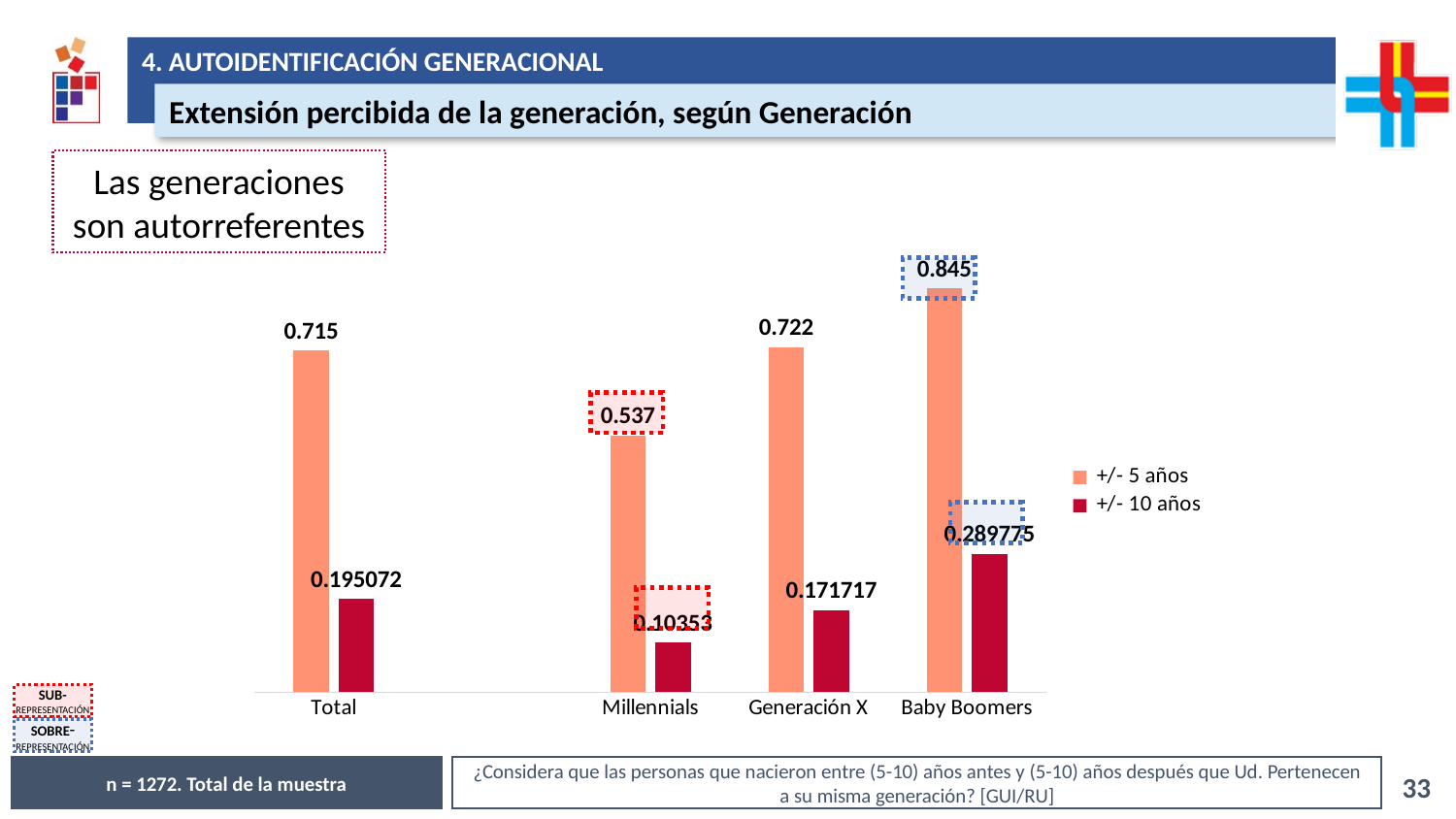
What is the value for Baby Boomers in the +/- 5 años series? 0.845 What kind of chart is shown on the slide? Bar chart What is the difference between the +/- 5 años values for Baby Boomers and Millennials? 0.308 How many series does the legend list? 2 What is the value for Millennials in the +/- 10 años series? 0.10353 What is the value for Generación X in the +/- 5 años series? 0.722 Which category has the lowest value in the +/- 10 años series? Millennials Which is larger: the +/- 10 años value for Generación X or for Baby Boomers? Baby Boomers Which category has the highest value in the +/- 5 años series? Baby Boomers How many categories are shown on the x axis? 4 What is the value for Total in the +/- 10 años series? 0.195072 Which series is shown in dark red in the legend? +/- 10 años